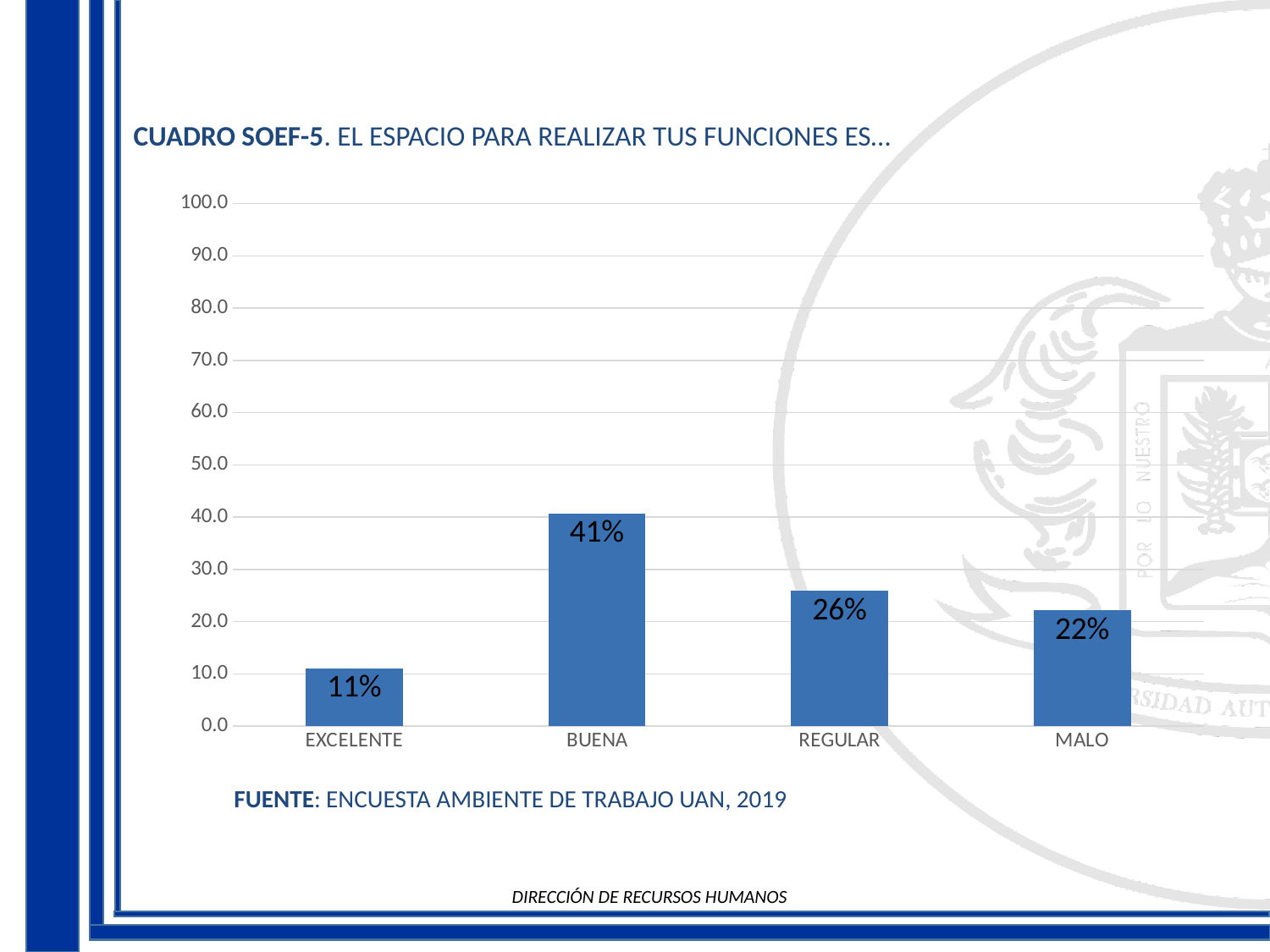
What is the source cited below the chart? ENCUESTA AMBIENTE DE TRABAJO UAN, 2019 What kind of chart is shown on the slide? Bar chart Which category has the lowest value? EXCELENTE What is the value for REGULAR? 26% Which category has the highest value? BUENA What is the value for EXCELENTE? 11% What is the value for BUENA? 41% How many categories are shown on the x axis? 4 What is the value for MALO? 22% Is the value for BUENA greater or less than 30.0? greater What is the difference between the values for BUENA and REGULAR? 15% Which is larger, the value for REGULAR or the value for MALO? REGULAR